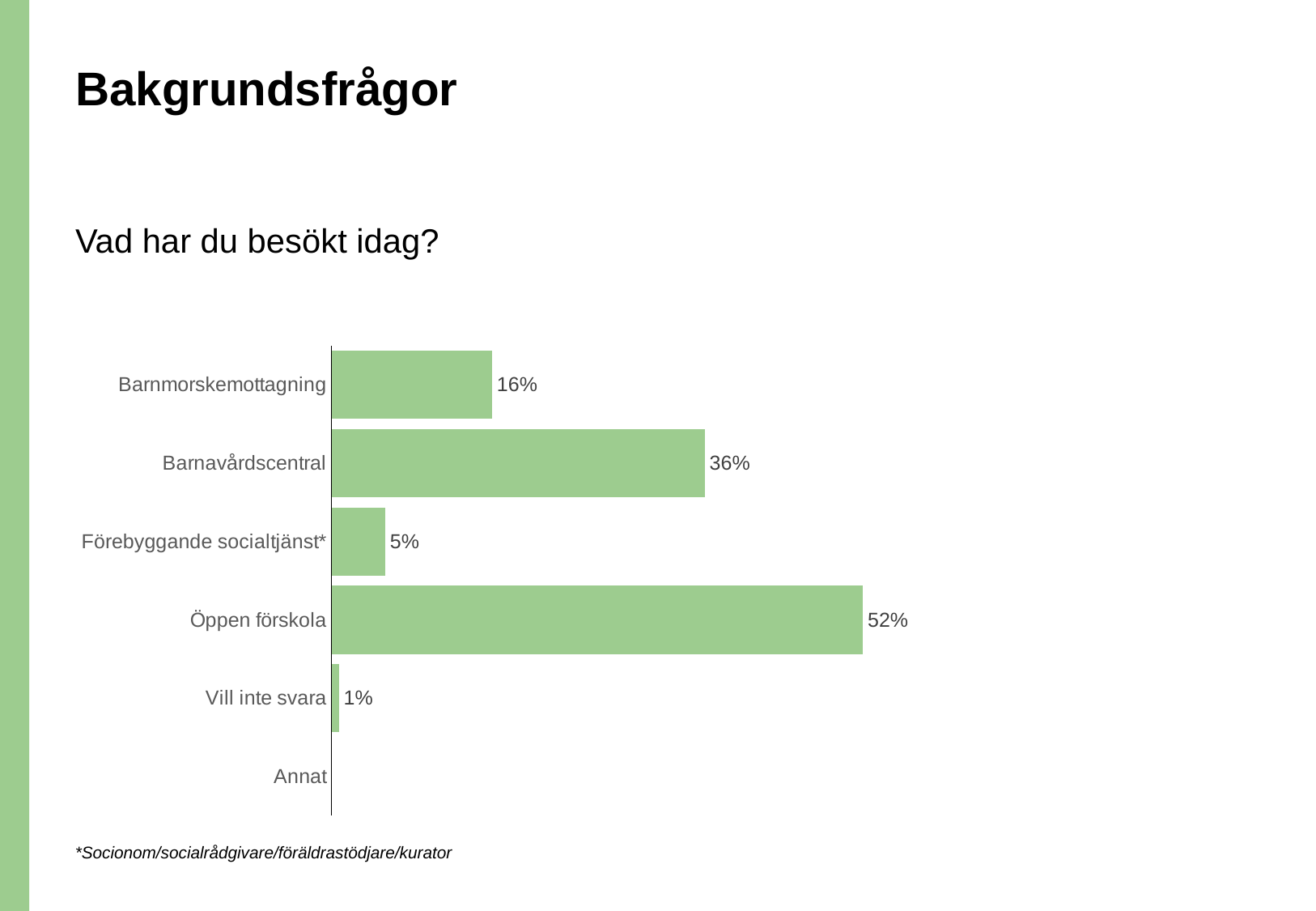
Which category with a labelled value has the lowest value? Vill inte svara Which is larger, the value for Barnmorskemottagning or the value for Förebyggande socialtjänst*? Barnmorskemottagning What is the value for Barnavårdscentral? 36% How many categories are listed on the chart? 6 What is the value for Vill inte svara? 1% What is the difference between the values for Öppen förskola and Barnavårdscentral? 16% Which category has the highest value? Öppen förskola What is the value for Förebyggande socialtjänst*? 5% What is the value for Öppen förskola? 52% What is the value for Barnmorskemottagning? 16% What question does the chart answer, as written above it? Vad har du besökt idag? What kind of chart is shown on the slide? Bar chart